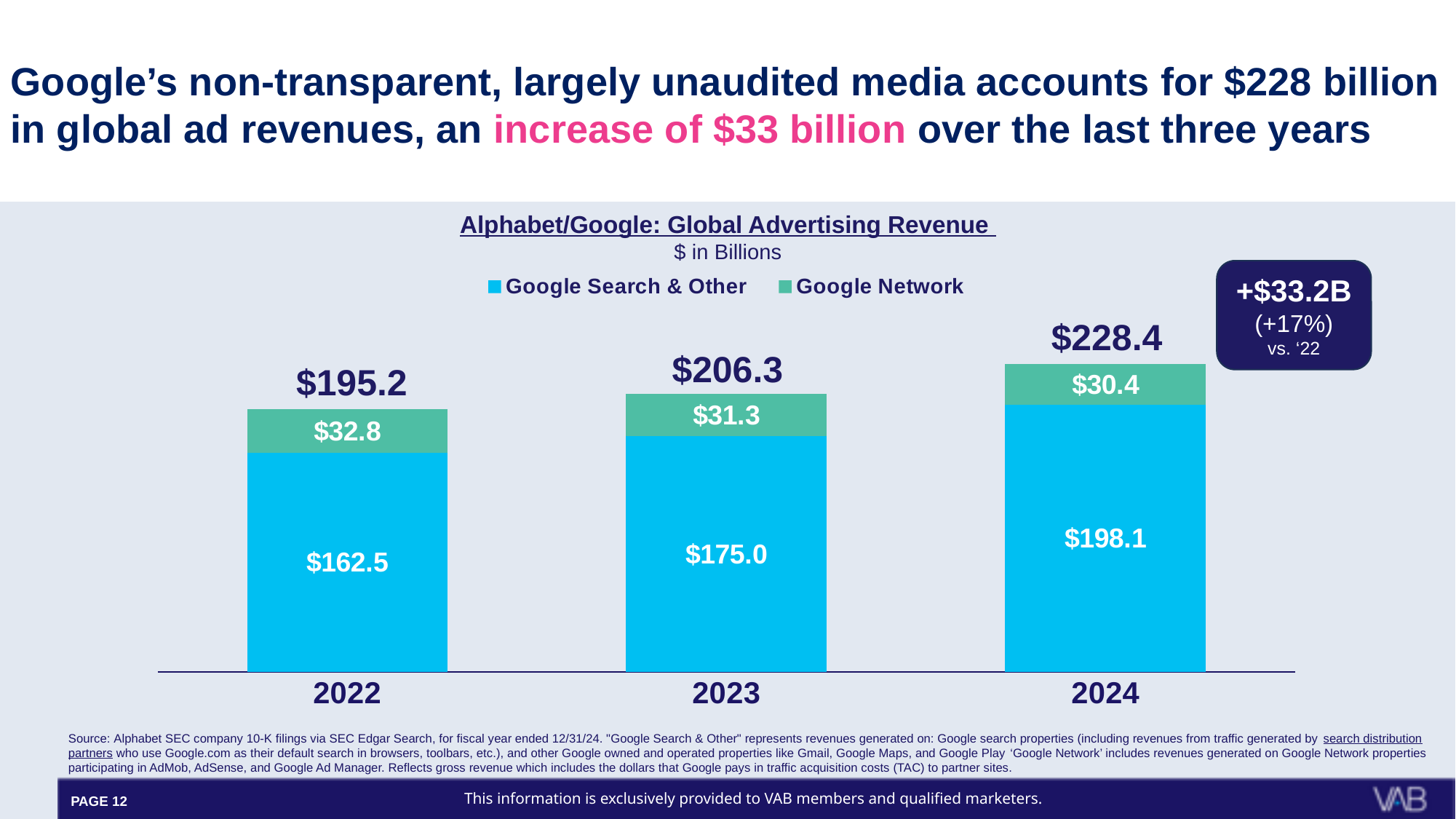
Is the Google Network value larger in 2022 or in 2023? 2022 What is the total of the stacked bar for 2024? $228.4 Which year has the highest total global advertising revenue? 2024 Do the total revenue values rise or fall from 2022 to 2024? Rise Which year has the lowest Google Network value? 2024 What is the difference between the Google Search & Other values for 2024 and 2022? $35.6 What is the Google Network value for 2022? $32.8 What is the Google Search & Other value for 2023? $175.0 How many series does the legend list? 2 What is the title of the chart? Alphabet/Google: Global Advertising Revenue What kind of chart is shown? Stacked bar chart How many years are shown on the x axis? 3